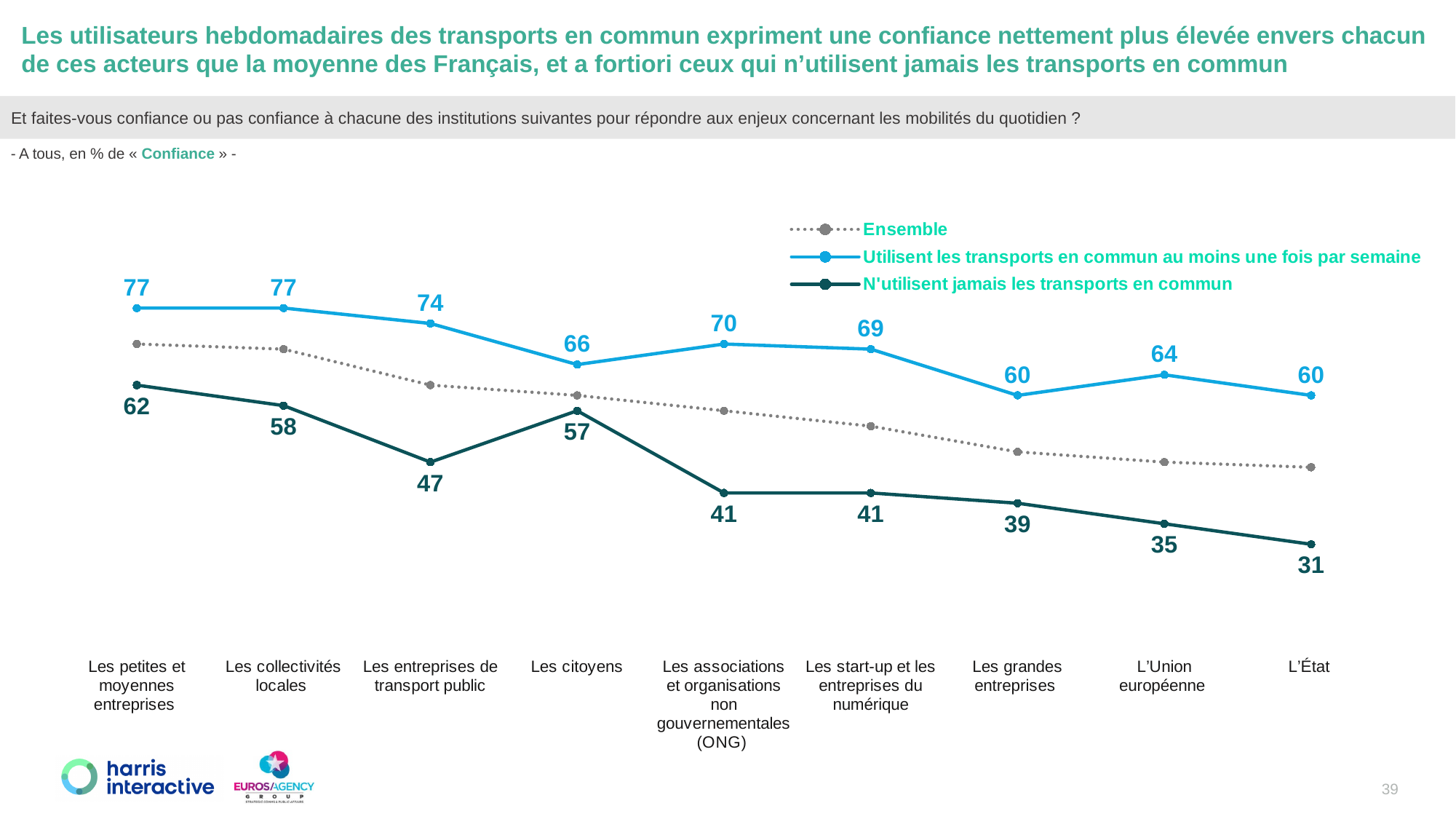
What is the value for "L'État" in the series "N'utilisent jamais les transports en commun"? 31 How many series does the legend list? 3 Which institution has the lowest value in the series "Utilisent les transports en commun au moins une fois par semaine"? Les grandes entreprises and L'État (both 60) How many institutions are shown along the x axis? 9 Which institution has the lowest value in the series "N'utilisent jamais les transports en commun"? L'État What is the difference between the weekly users' value and the never-users' value for "Les start-up et les entreprises du numérique"? 28 For "L'Union européenne", which series has the larger value: "Utilisent les transports en commun au moins une fois par semaine" or "N'utilisent jamais les transports en commun"? Utilisent les transports en commun au moins une fois par semaine Does the "Ensemble" series generally rise or fall from left to right across the x axis? fall Which series is drawn as a dotted grey line? Ensemble What is the value for "Les citoyens" in the series "N'utilisent jamais les transports en commun"? 57 What is the value for "Les entreprises de transport public" in the series "Utilisent les transports en commun au moins une fois par semaine"? 74 What kind of chart is shown on the slide? line chart